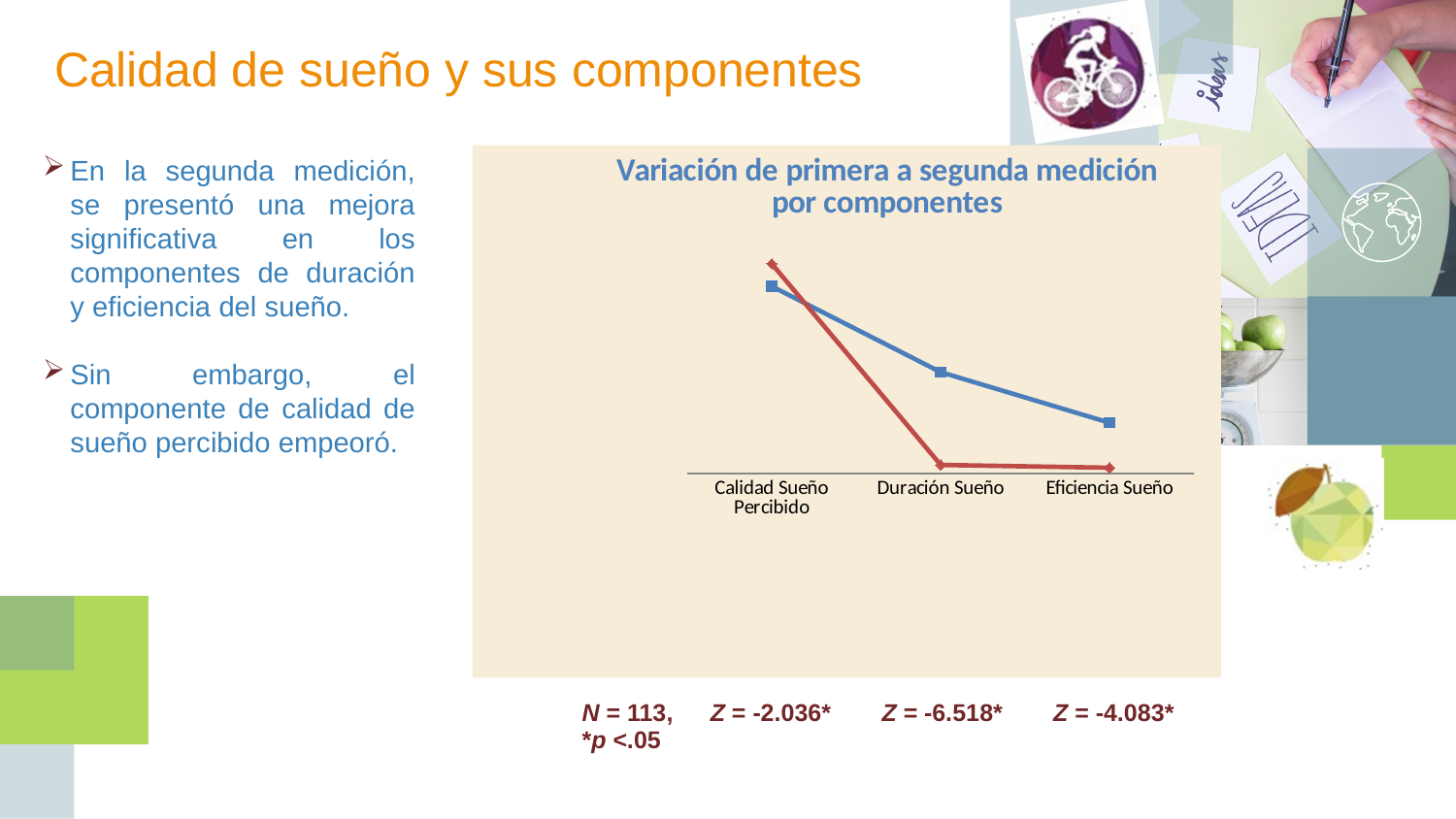
Do the values of the red line rise or fall from Calidad Sueño Percibido to Eficiencia Sueño? fall How many categories are shown on the x axis of the chart? 3 For the red line, which category has the highest value? Calidad Sueño Percibido What are the colours of the two lines in the chart? blue and red For the blue line, which category has the highest value? Calidad Sueño Percibido How many lines are plotted in the chart? 2 Do the values of the blue line rise or fall from Calidad Sueño Percibido to Eficiencia Sueño? fall For the blue line, which category has the lowest value? Eficiencia Sueño What kind of chart is shown on the slide? line chart At Eficiencia Sueño, which line has the larger value, the blue line or the red line? the blue line At Duración Sueño, which line has the larger value, the blue line or the red line? the blue line What is the title of the chart? Variación de primera a segunda medición por componentes